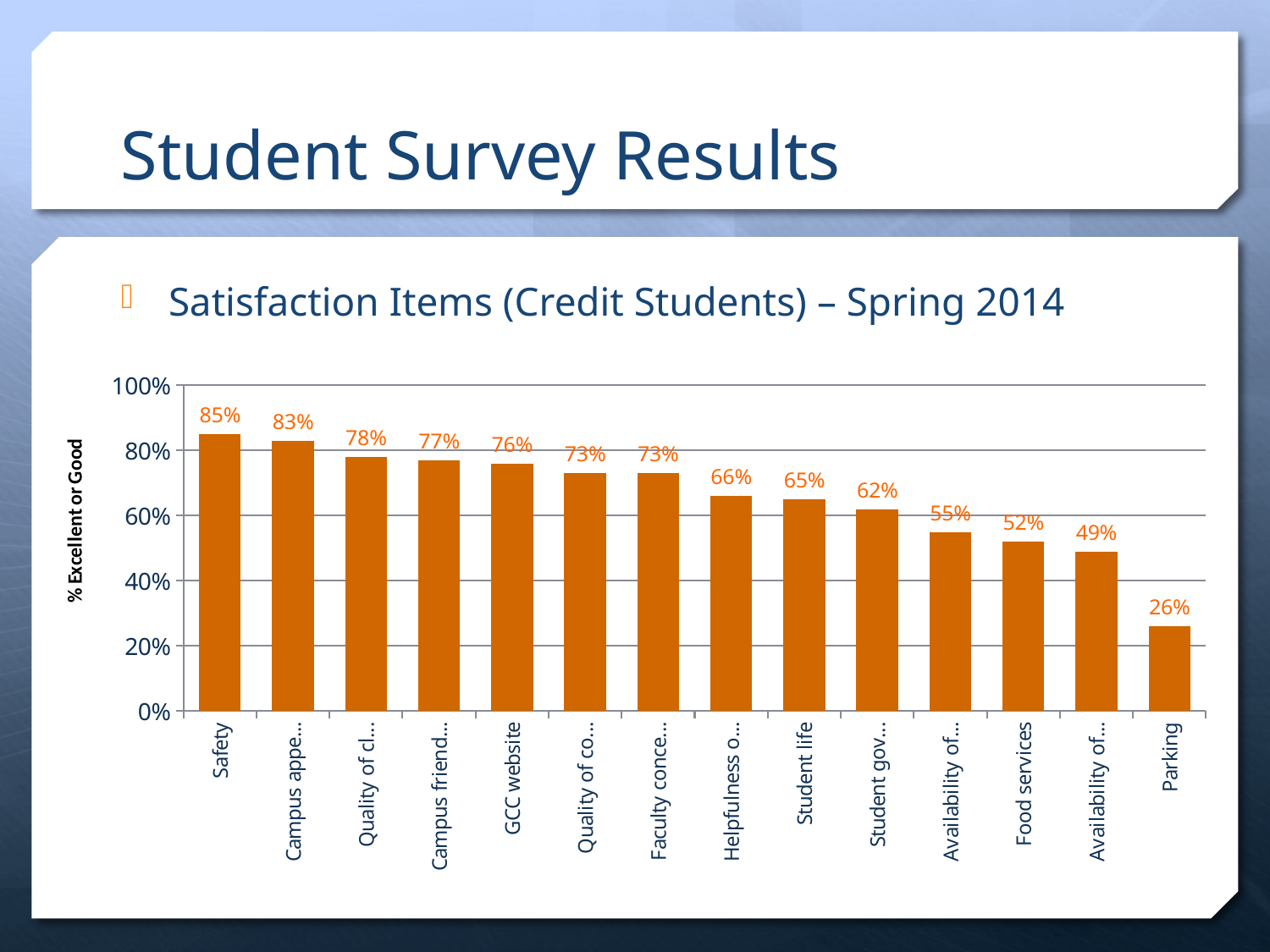
What is the difference between the values for Safety and Parking? 59 percentage points Which category has the lowest value? Parking What is the value for Safety? 85% What is the value for GCC website? 76% What is the value for Student life? 65% What is the value for Food services? 52% Which is larger, the value for GCC website or the value for Student life? GCC website Which category has the highest value? Safety What is the value for Parking? 26% How many categories are shown in the chart? 14 Do the values rise or fall from left to right along the x axis? Fall What kind of chart is shown on the slide? Bar chart